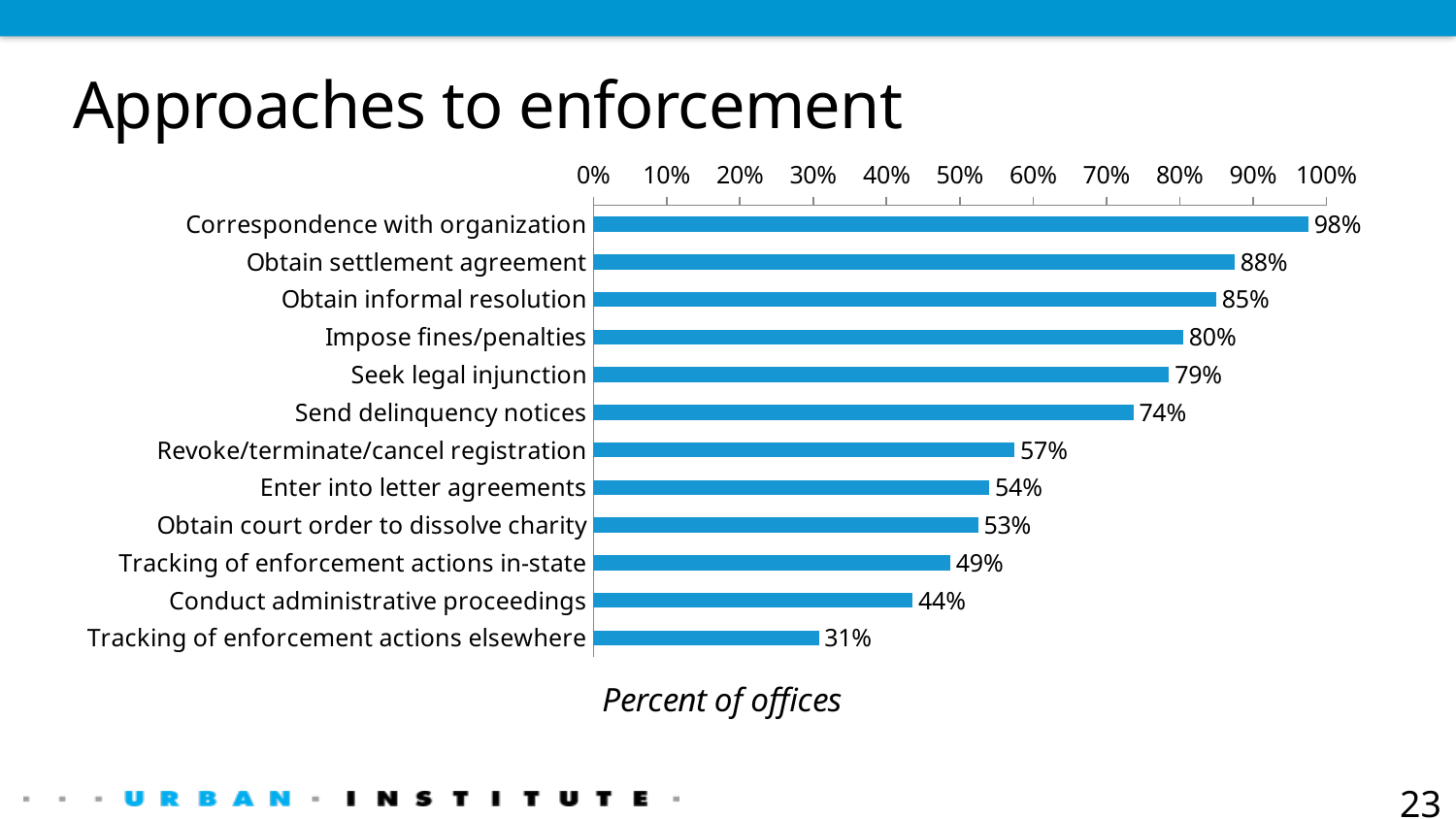
Which enforcement approach has the lowest percent of offices? Tracking of enforcement actions elsewhere Is the value for Tracking of enforcement actions in-state greater or less than 50%? less Which is larger: Impose fines/penalties or Revoke/terminate/cancel registration? Impose fines/penalties What percent of offices use correspondence with organization as an enforcement approach? 98% What kind of chart is shown on the slide? Bar chart What percent of offices conduct administrative proceedings? 44% What is the difference between Send delinquency notices and Tracking of enforcement actions elsewhere? 43% What is the value for Seek legal injunction? 79% How many enforcement approaches are shown in the chart? 12 What is the title of the chart on the slide? Approaches to enforcement Which enforcement approach has the highest percent of offices? Correspondence with organization What is the difference between Obtain settlement agreement and Obtain informal resolution? 3%